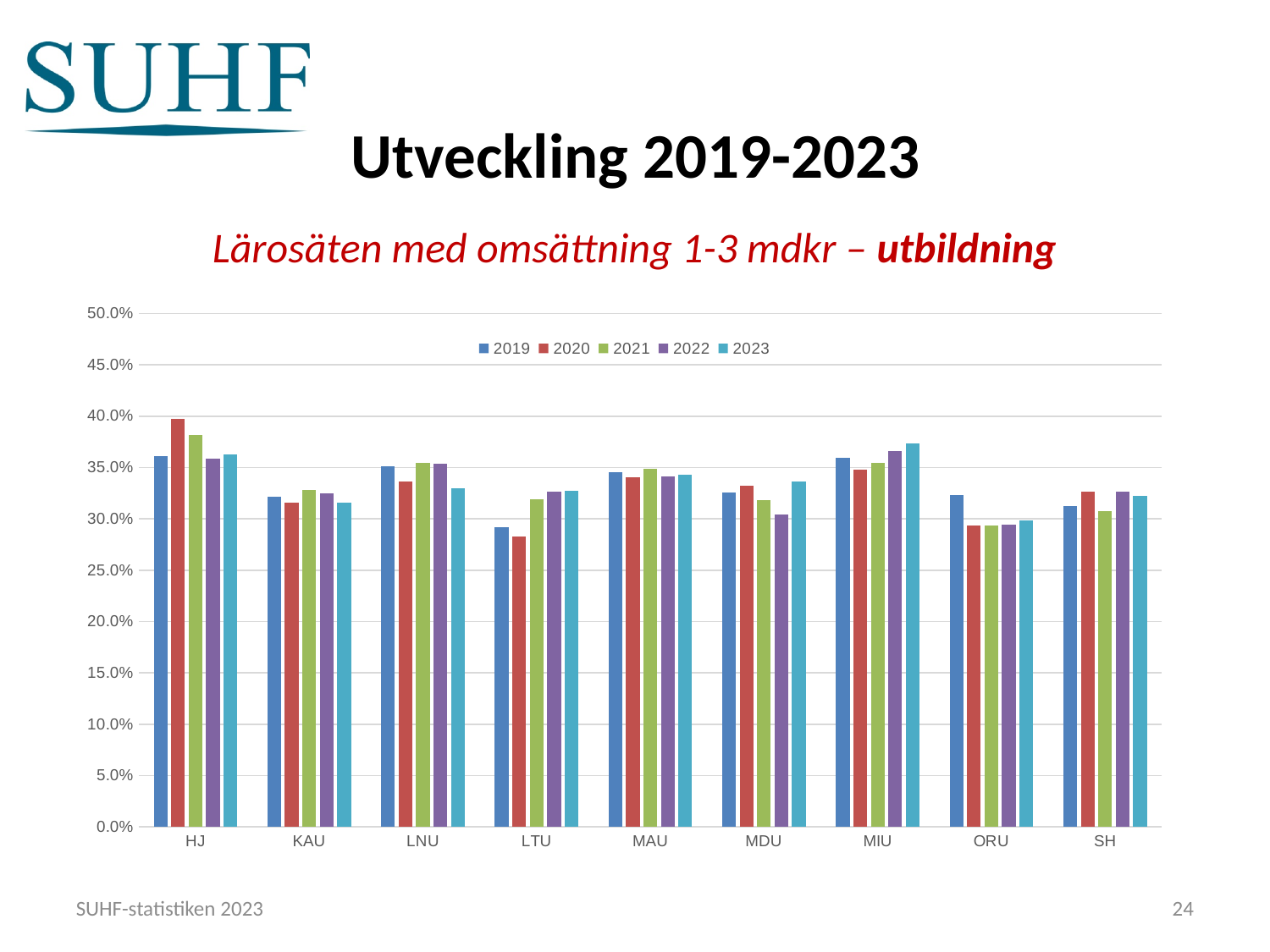
What kind of chart is shown on the slide? bar chart Which institution has the highest 2021 value? HJ For LTU, which is larger: the 2019 value or the 2023 value? 2023 How many series does the legend list? 5 What is the subtitle of the chart shown in red text? Lärosäten med omsättning 1-3 mdkr – utbildning Which institution has the highest 2020 value? HJ Is the 2019 value for KAU greater or less than 30%? greater How many institutions (categories) are shown on the x axis? 9 Is the 2023 value for MIU greater or less than 35%? greater Is the 2020 value for LTU greater or less than 30%? less For HJ, which is larger: the 2020 value or the 2023 value? 2020